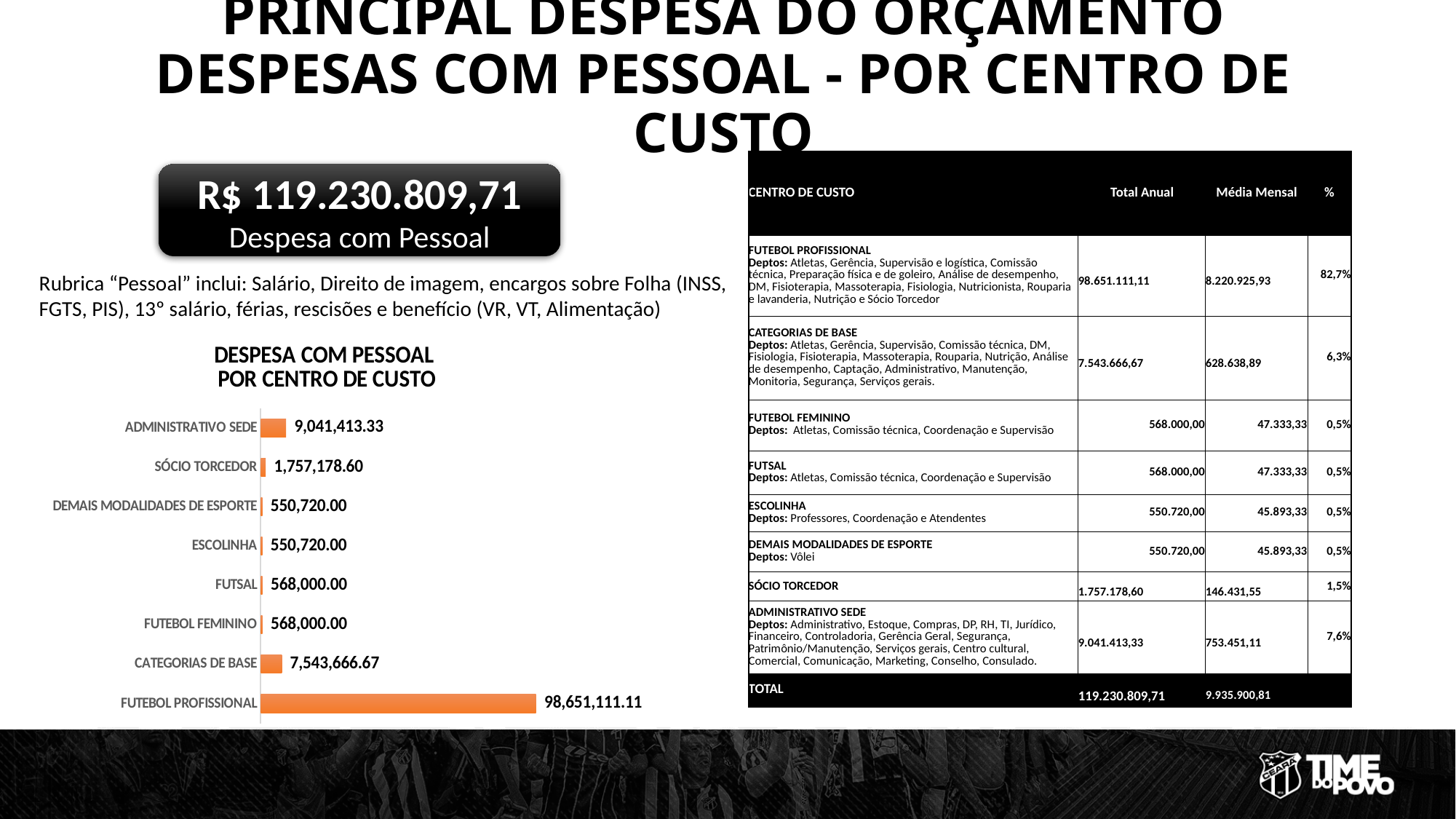
What kind of chart is shown on the slide? Bar chart How many categories are shown in the bar chart? 8 What is the title of the chart on the slide? DESPESA COM PESSOAL POR CENTRO DE CUSTO What is the value for ADMINISTRATIVO SEDE in the bar chart? 9,041,413.33 Which is larger in the bar chart, the value for ADMINISTRATIVO SEDE or the value for CATEGORIAS DE BASE? ADMINISTRATIVO SEDE What is the difference between the values for ADMINISTRATIVO SEDE and CATEGORIAS DE BASE in the bar chart? 1,497,746.66 What is the value for FUTEBOL PROFISSIONAL in the bar chart? 98,651,111.11 What is the value for SÓCIO TORCEDOR in the bar chart? 1,757,178.60 What is the value for FUTSAL in the bar chart? 568,000.00 Which category has the highest value in the bar chart? FUTEBOL PROFISSIONAL What is the difference between the values for FUTEBOL PROFISSIONAL and CATEGORIAS DE BASE in the bar chart? 91,107,444.44 What is the value for CATEGORIAS DE BASE in the bar chart? 7,543,666.67